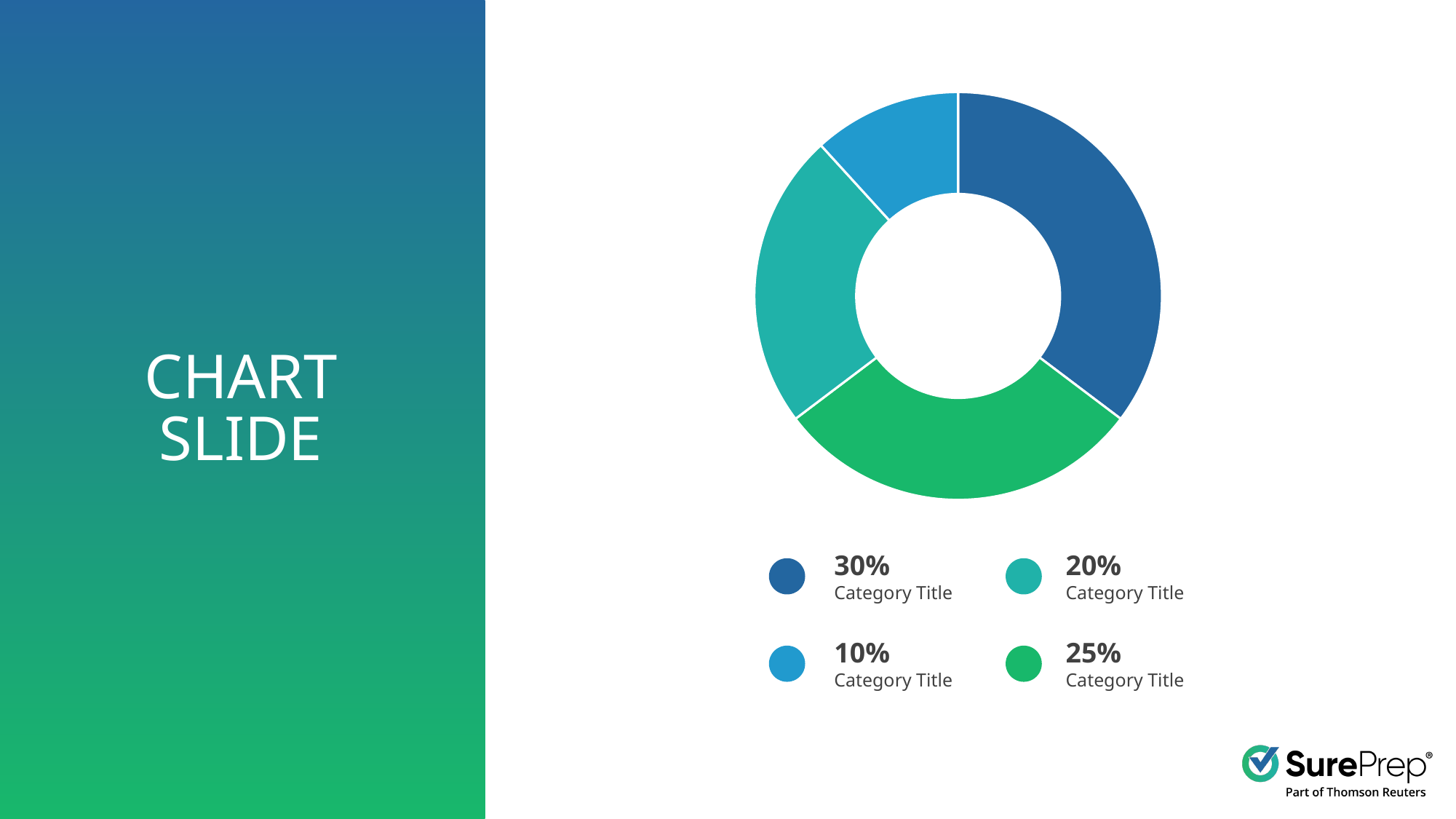
Which slice of the donut chart has the smallest percentage? The light blue slice (10%) How many slices does the donut chart have? 4 What percentage is shown for the dark blue slice of the donut chart? 30% What kind of chart is shown on the slide? Donut chart Which is larger in the donut chart, the teal slice or the green slice? The green slice What is the difference between the teal slice and the light blue slice in the donut chart? 10% What label text is given for each category in the donut chart's legend? Category Title Which slice of the donut chart has the largest percentage? The dark blue slice (30%) What is the difference between the dark blue slice and the green slice in the donut chart? 5% What percentage is shown for the teal slice of the donut chart? 20% What percentage is shown for the light blue slice of the donut chart? 10% What percentage is shown for the green slice of the donut chart? 25%